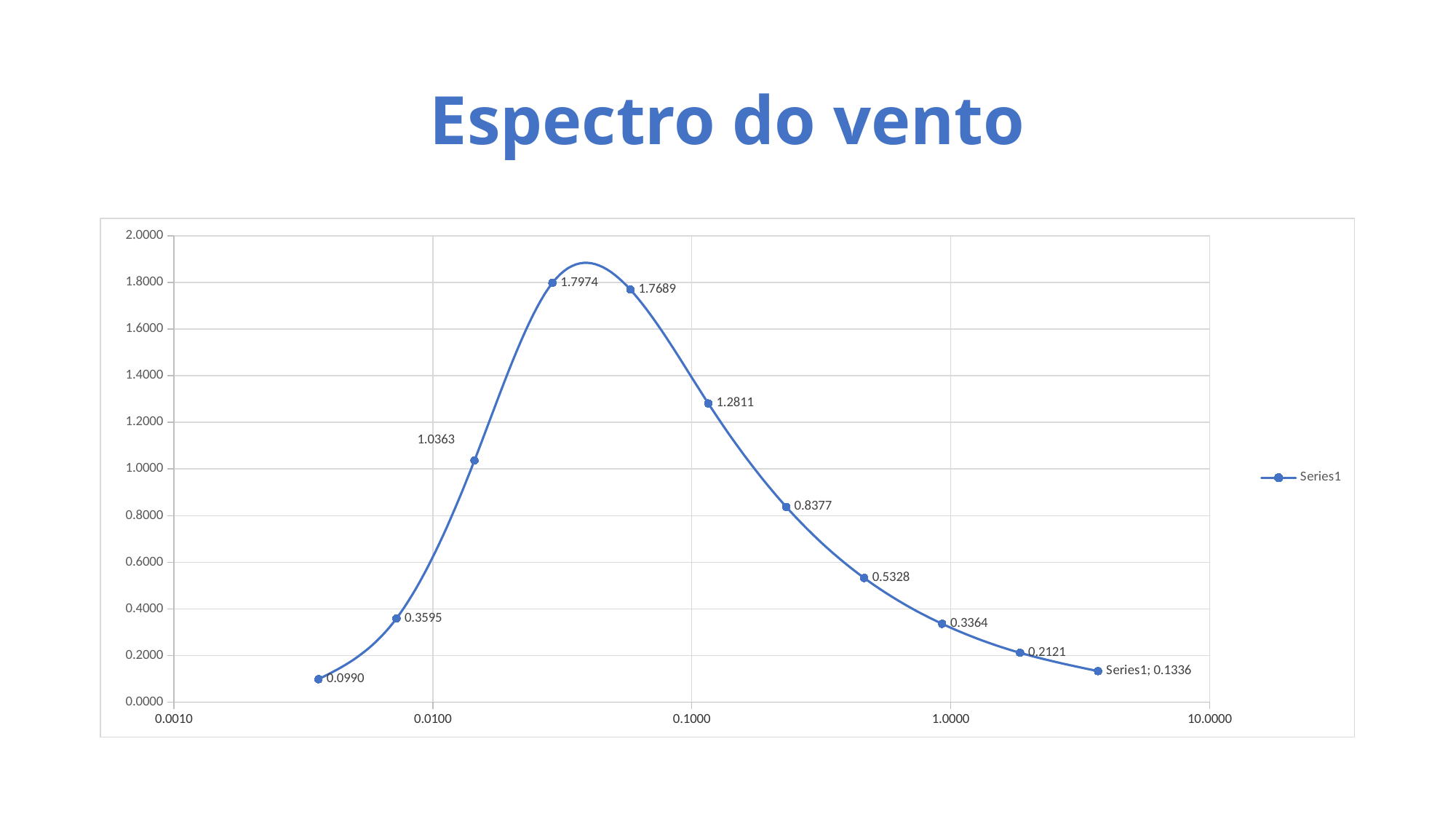
What is the title of the chart on the slide? Espectro do vento What is the difference between the highest labelled value and the lowest labelled value? 1.6984 How many series does the legend list? 1 What is the difference between the two highest labelled values, 1.7974 and 1.7689? 0.0285 After reaching the peak, do the values rise or fall as you move to the right along the x axis? fall What is the highest data value labelled on the chart? 1.7974 Is the value of the rightmost data point greater or less than 0.2000? less What is the lowest data value labelled on the chart? 0.0990 How many data points are plotted on the chart? 11 What kind of chart is shown on the slide? line chart What is the value of the leftmost data point on the chart? 0.0990 What is the value of the rightmost data point on the chart? 0.1336